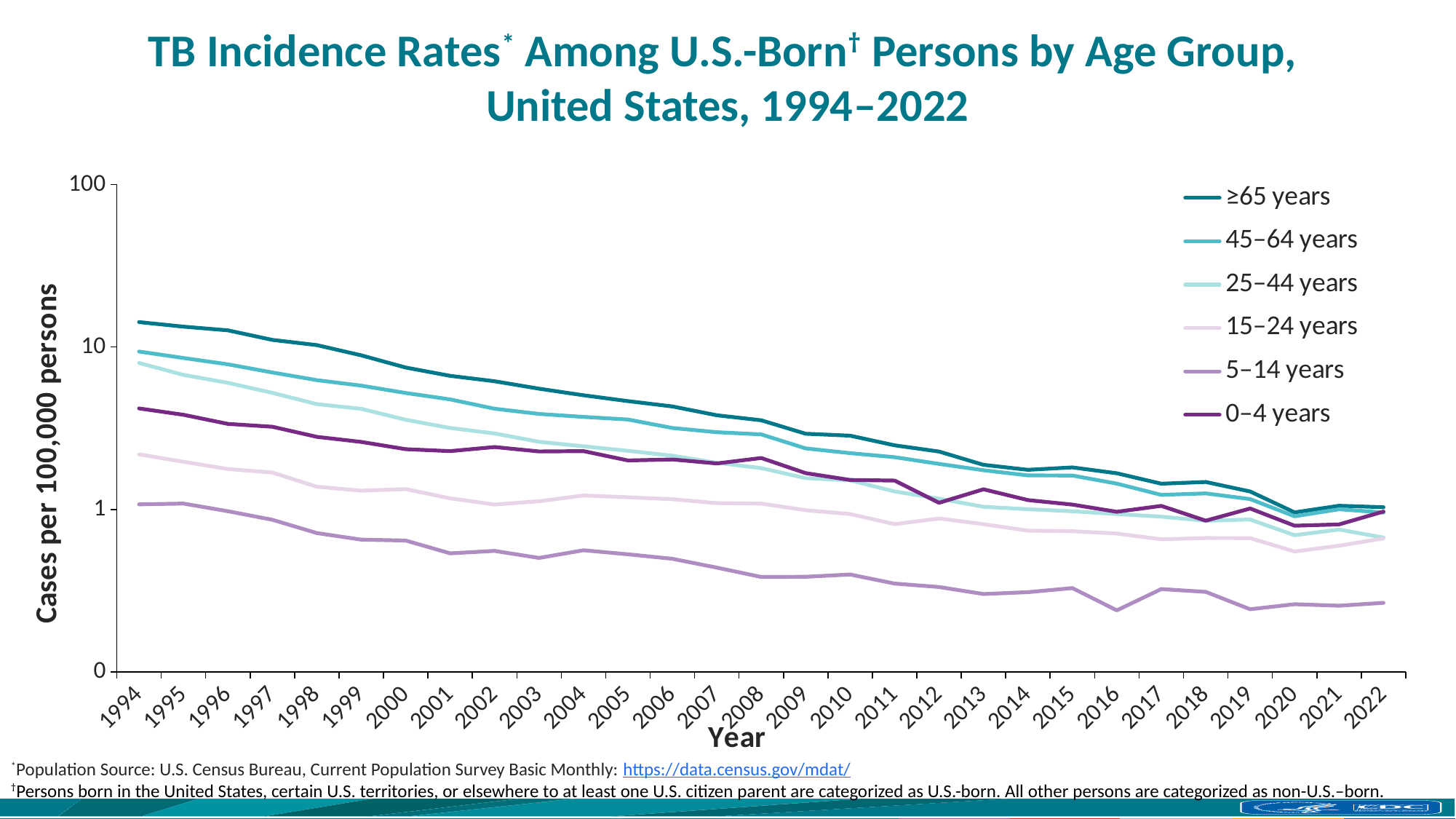
How many years are plotted along the x axis? 29 Is the value for 5–14 years in 2022 greater or less than 1? less Which age group has the highest TB incidence rate in 1994? ≥65 years What is the label of the y axis? Cases per 100,000 persons Is the value for 0–4 years in 1994 greater or less than 10? less In 1994, which is larger: the value for 0–4 years or the value for 15–24 years? 0–4 years How many series does the legend list? 6 Is the value for ≥65 years in 1994 greater or less than 10? greater Does the TB incidence rate for ≥65 years generally rise or fall from 1994 to 2022? Fall Which age group has the lowest TB incidence rate in 1994? 5–14 years What kind of chart is shown on the slide? Line chart Which age group has the lowest TB incidence rate in 2022? 5–14 years